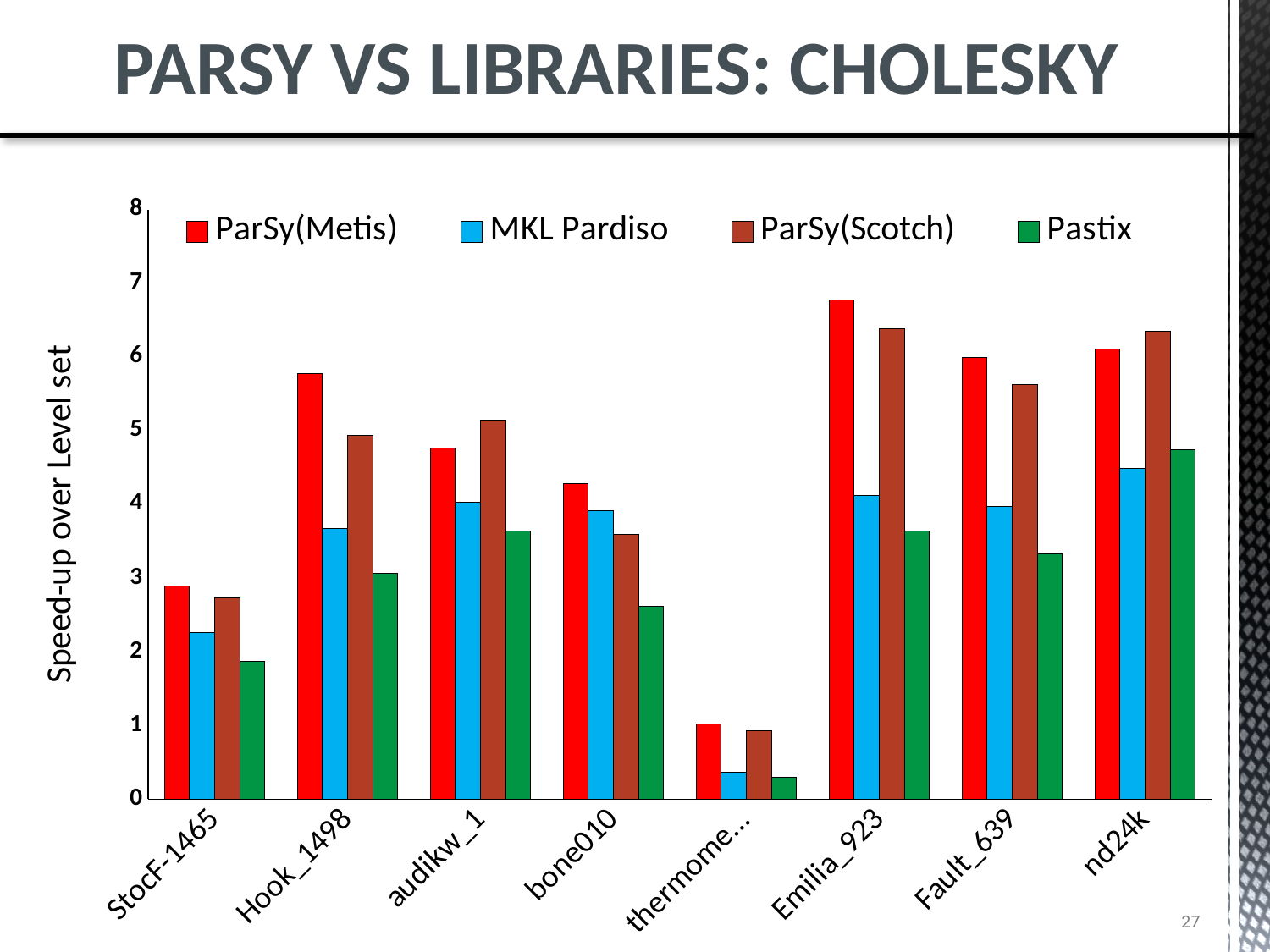
How many matrix categories are shown along the x axis? 8 What kind of chart is shown on the slide? bar chart Is the ParSy(Metis) value for Emilia_923 greater or less than 6? greater What is the label of the y axis? Speed-up over Level set Which series is drawn in green? Pastix Is the Pastix value for StocF-1465 greater or less than 2? less For audikw_1, which is larger: ParSy(Metis) or ParSy(Scotch)? ParSy(Scotch) Is the MKL Pardiso value for Hook_1498 greater or less than 3? greater How many series does the legend list? 4 Which category has the highest Pastix value? nd24k Which category has the highest ParSy(Metis) value? Emilia_923